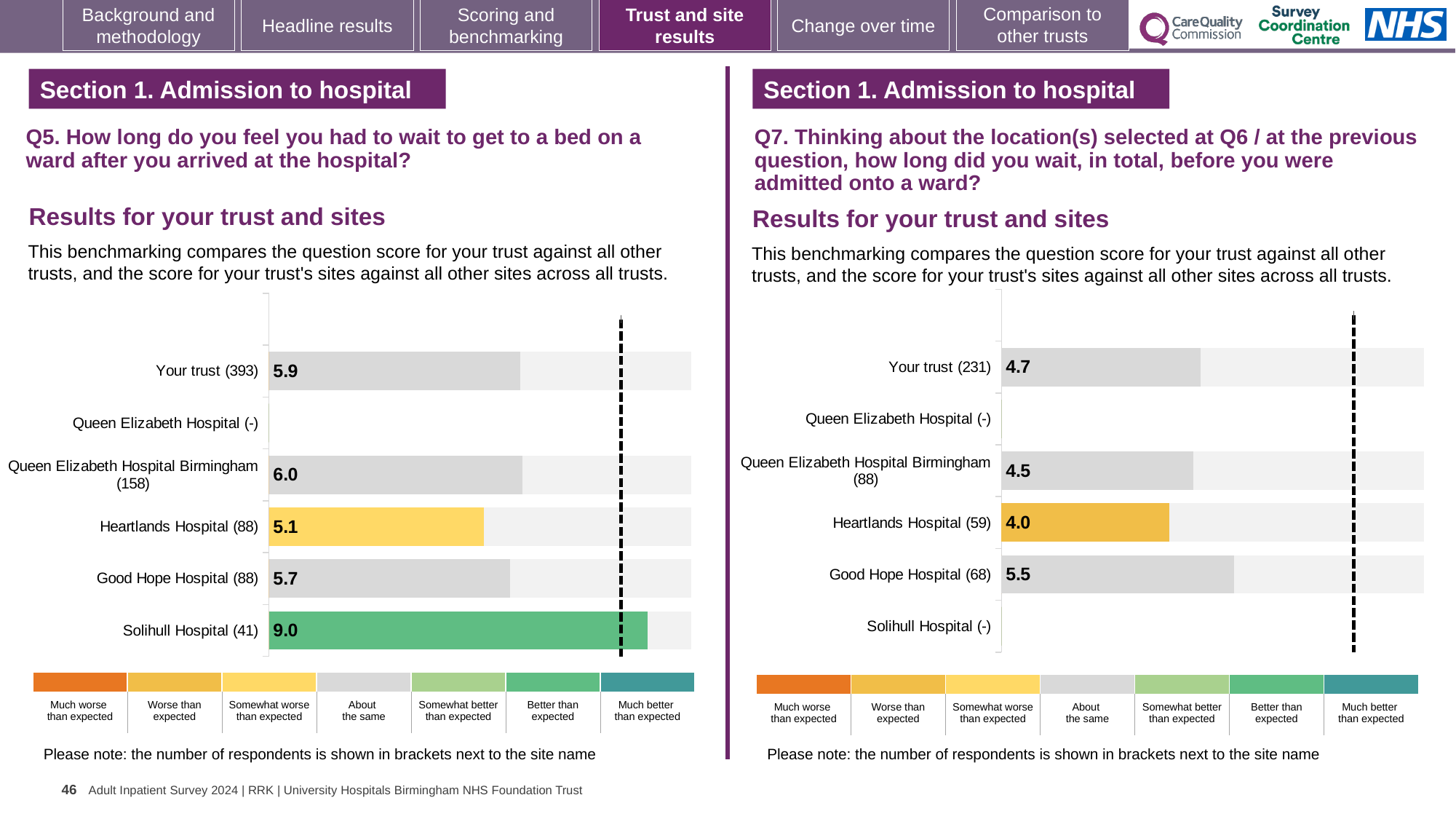
In the Q7 chart on the right, how many rows have a score shown? 4 In the Q5 chart on the left, which has the higher score: Queen Elizabeth Hospital Birmingham or Good Hope Hospital? Queen Elizabeth Hospital Birmingham In the Q7 chart on the right, which site has the highest score? Good Hope Hospital (68) In the Q7 chart on the right, what is the difference between the scores for Good Hope Hospital and Queen Elizabeth Hospital Birmingham? 1.0 In the Q5 chart on the left, what is the score for Your trust (393)? 5.9 In the Q5 chart on the left, which site has the highest score? Solihull Hospital (41) In the Q7 chart on the right, what is the score for Heartlands Hospital (59)? 4.0 In the Q5 chart on the left, which site has the lowest score? Heartlands Hospital (88) What type of chart is used on the left for Q5? Bar chart In the Q5 chart on the left, what is the score for Solihull Hospital (41)? 9.0 In the Q7 chart on the right, what is the score for Your trust (231)? 4.7 In the Q5 chart on the left, what is the difference between the scores for Solihull Hospital and Heartlands Hospital? 3.9